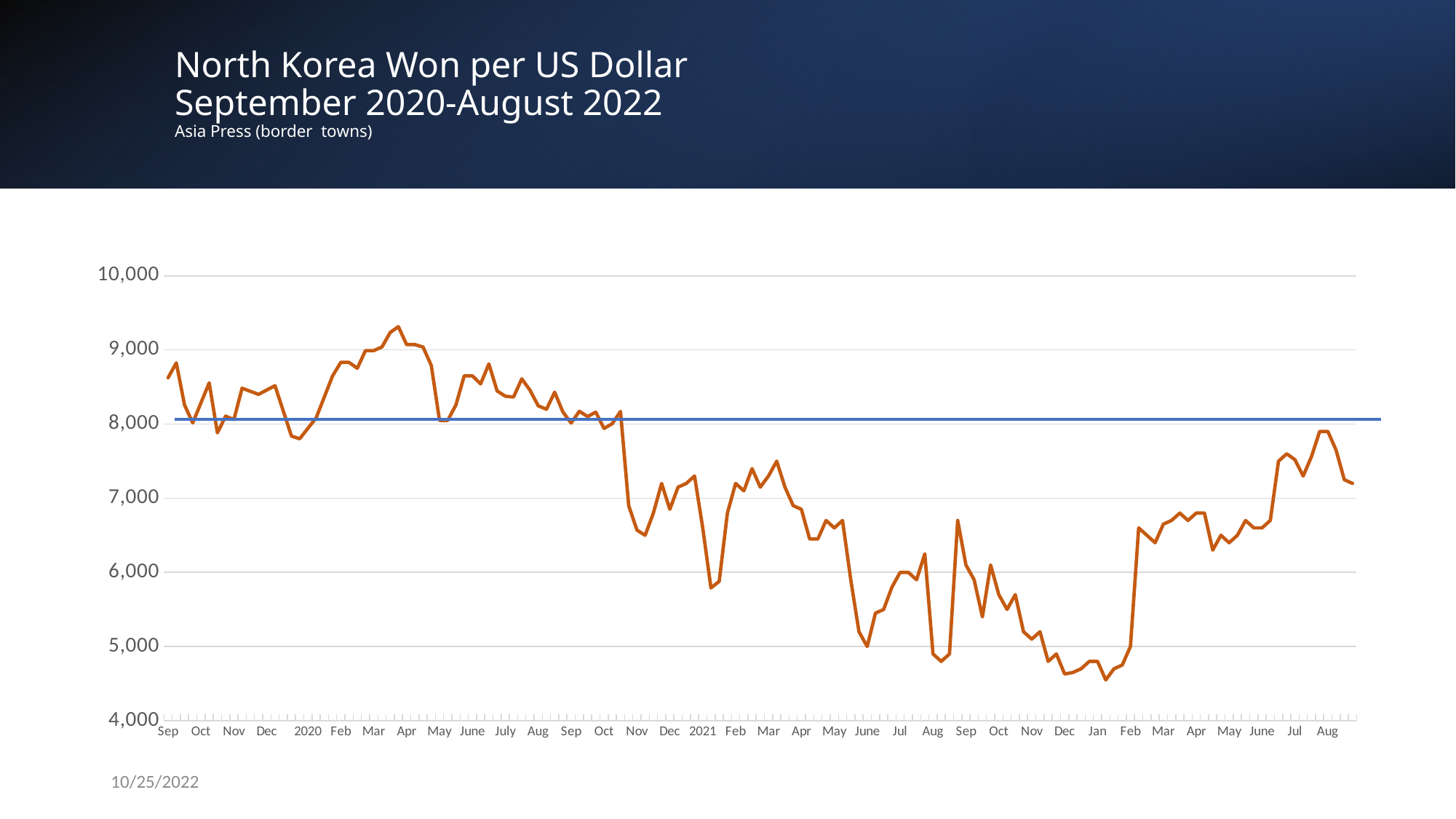
Is the value at Jan 2022 greater or less than 5,000? less Does the orange line rise or fall between Apr 2020 and Jan 2022? Fall Around which month does the orange line reach its lowest point? Jan 2022 Around which month does the orange line reach its highest point? Apr 2020 What kind of chart is shown on the slide? Line chart What source is cited under the chart title? Asia Press (border towns) What is the title of the chart? North Korea Won per US Dollar September 2020-August 2022 Is the value at Jul 2022 greater or less than 8,000? less Is the value at Nov 2020 greater or less than 8,000? less Does the orange line rise or fall between Jan 2022 and Jul 2022? Rise